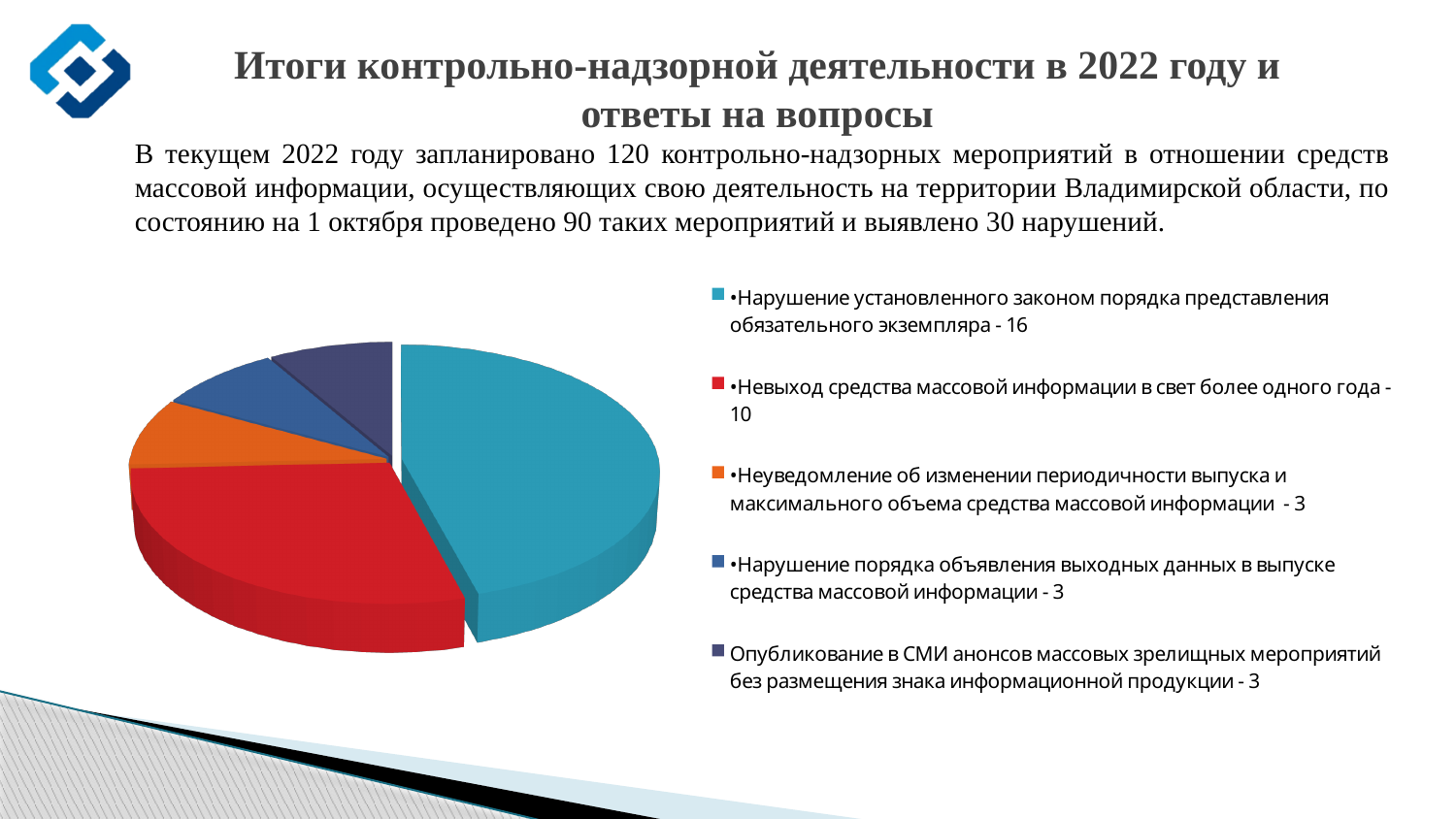
Which category has the largest slice of the pie chart? Нарушение установленного законом порядка представления обязательного экземпляра What is the value for "Нарушение установленного законом порядка представления обязательного экземпляра"? 16 What is the difference between the values for "Нарушение установленного законом порядка представления обязательного экземпляра" and "Невыход средства массовой информации в свет более одного года"? 6 What is the value for "Неуведомление об изменении периодичности выпуска и максимального объема средства массовой информации"? 3 What colour is the largest slice of the pie chart? teal blue What is the value for "Невыход средства массовой информации в свет более одного года"? 10 How many entries does the legend of the pie chart list? 5 What kind of chart is shown on the slide? pie chart Which is larger: the value for "Невыход средства массовой информации в свет более одного года" or for "Нарушение порядка объявления выходных данных в выпуске средства массовой информации"? Невыход средства массовой информации в свет более одного года What is the total of all the values shown in the pie chart legend? 35 How many slices does the pie chart have? 5 What is the value for "Опубликование в СМИ анонсов массовых зрелищных мероприятий без размещения знака информационной продукции"? 3